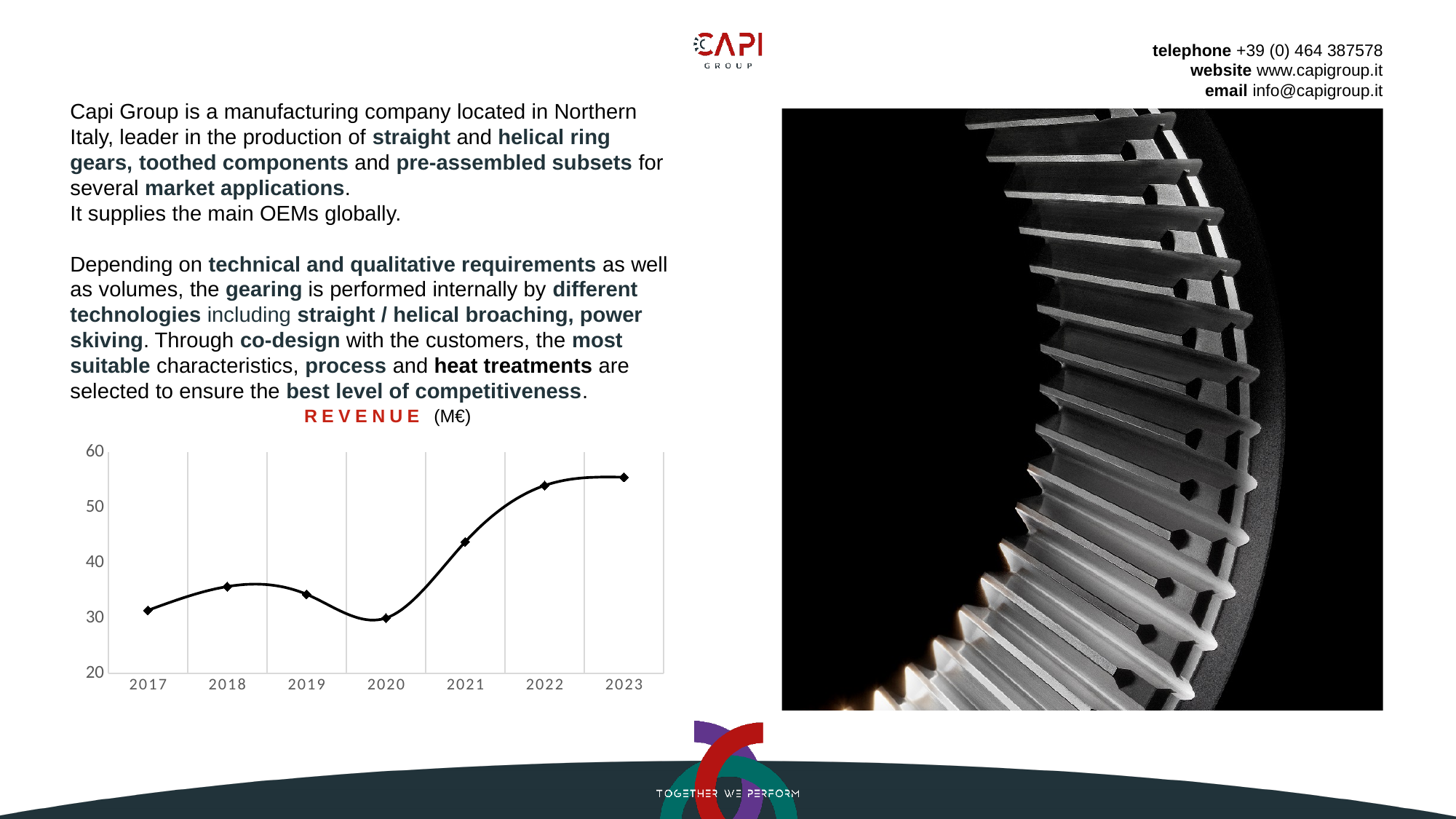
Which year has the lowest revenue on the chart? 2020 Is the revenue for 2021 greater or less than 40? greater How many years are plotted on the revenue chart? 7 Does revenue rise or fall from 2020 to 2023? rise Is the revenue for 2017 greater or less than 40? less Is the revenue for 2022 greater or less than 50? greater What kind of chart is used to show revenue on the slide? line chart Which year has higher revenue, 2019 or 2021? 2021 What is the title of the chart? REVENUE (M€) What is the highest value shown on the chart's vertical axis? 60